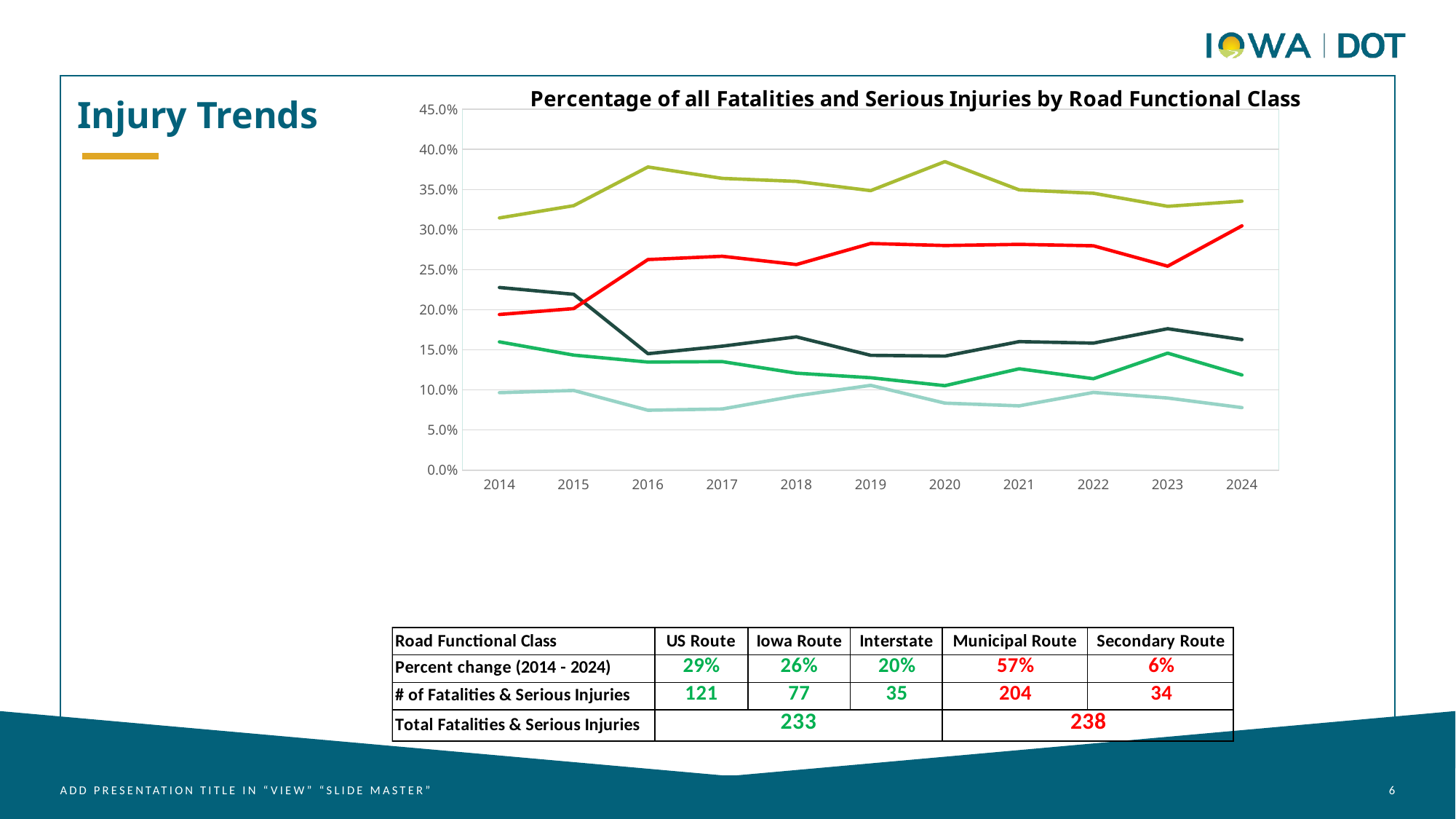
Is the value of the light teal line in 2016 greater or less than 10%? less How many years are plotted along the x axis of the chart? 11 Is the value of the dark green line in 2016 greater or less than 20%? less Is the value of the red line in 2024 greater or less than 25%? greater Which line stays highest across all years on the chart? the yellow-green (olive) line In 2014, which is higher: the dark green line or the red line? the dark green line What is the highest value shown on the chart's y axis? 45.0% What is the title of the chart? Percentage of all Fatalities and Serious Injuries by Road Functional Class Does the red line rise or fall overall from 2014 to 2024? rises What kind of chart is shown on the slide? line chart